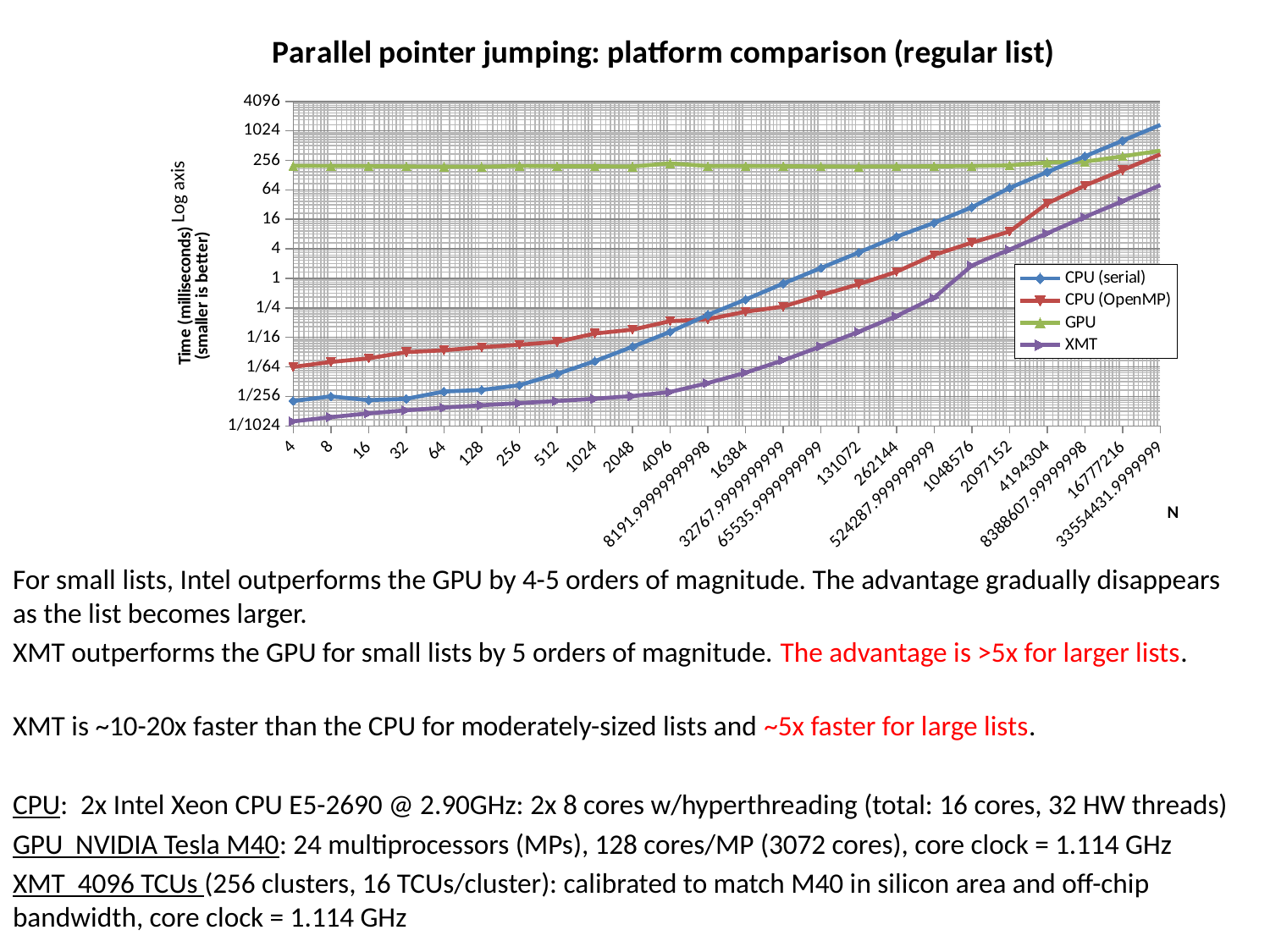
How many N values (points) are plotted along the x axis? 24 Which series has the lowest time at N = 4? XMT Which series has the highest time at the largest N (33554431.9999999)? CPU (serial) Which series has the highest time at N = 4? GPU What kind of chart is shown on the slide? line chart Is the XMT time at N = 4 greater or less than 1/256 milliseconds? less Is the CPU (serial) time at the largest N (33554431.9999999) greater or less than 1024 milliseconds? greater Which series has the lowest time at the largest N (33554431.9999999)? XMT Does the CPU (serial) time rise or fall as N increases along the x axis? rise At N = 131072, which is larger: the CPU (serial) time or the CPU (OpenMP) time? CPU (serial) How many series does the legend list? 4 Is the GPU time at N = 4 greater or less than 64 milliseconds? greater